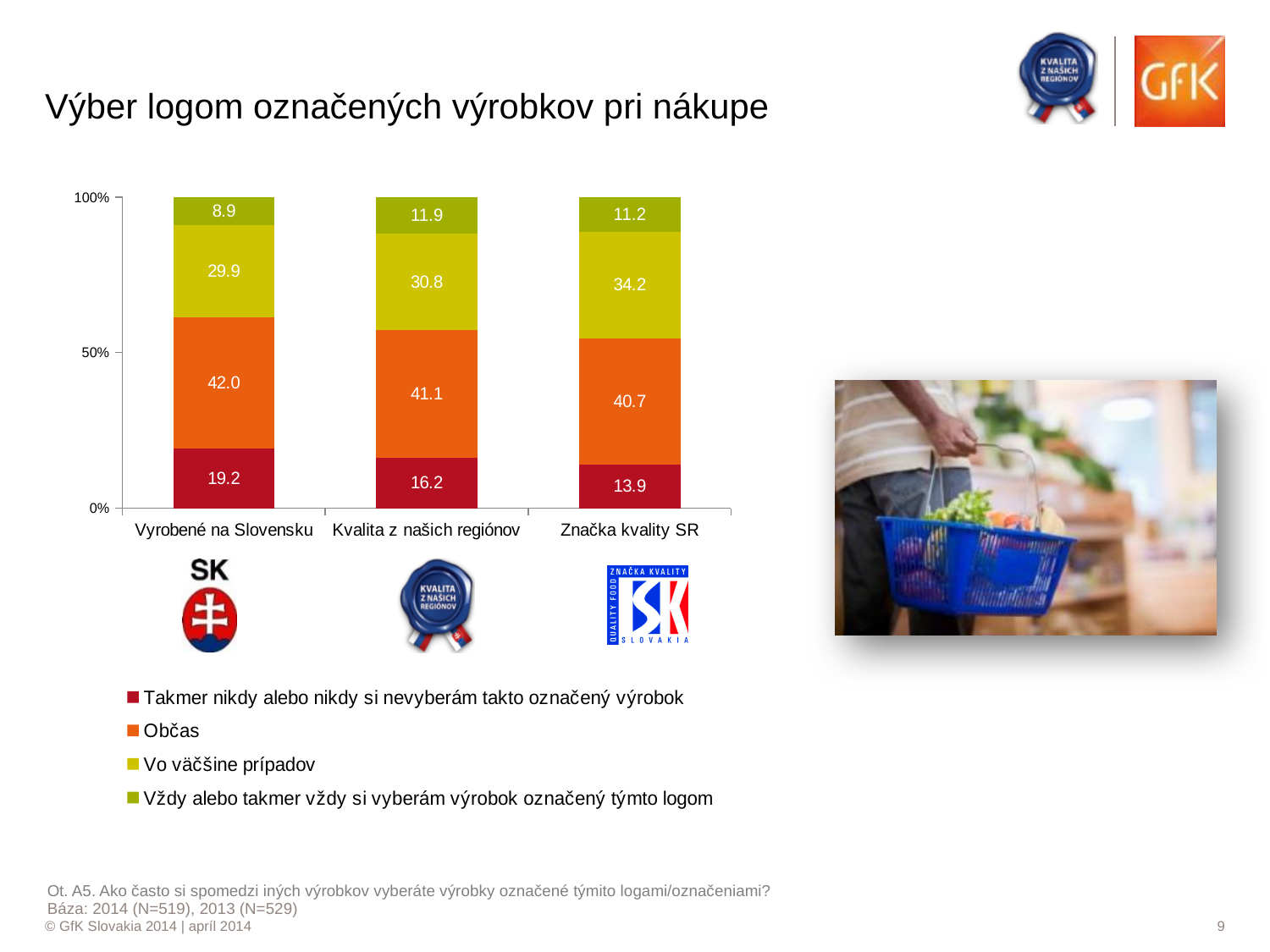
What is the total of the stacked bar for Kvalita z našich regiónov? 100.0 What is the value of "Takmer nikdy alebo nikdy si nevyberám takto označený výrobok" for Značka kvality SR? 13.9 What is the difference between the "Vo väčšine prípadov" values for Značka kvality SR and Vyrobené na Slovensku? 4.3 Which category has the lowest value for "Vždy alebo takmer vždy si vyberám výrobok označený týmto logom"? Vyrobené na Slovensku Which is larger: the "Občas" value for Vyrobené na Slovensku or for Značka kvality SR? Vyrobené na Slovensku What is the value of "Vždy alebo takmer vždy si vyberám výrobok označený týmto logom" for Kvalita z našich regiónov? 11.9 What is the value of "Občas" for Vyrobené na Slovensku? 42.0 What kind of chart is shown on the slide? Stacked bar chart How many categories are shown on the x axis of the chart? 3 How many series does the legend list? 4 What is the value of "Vo väčšine prípadov" for Značka kvality SR? 34.2 Which category has the highest value for "Takmer nikdy alebo nikdy si nevyberám takto označený výrobok"? Vyrobené na Slovensku